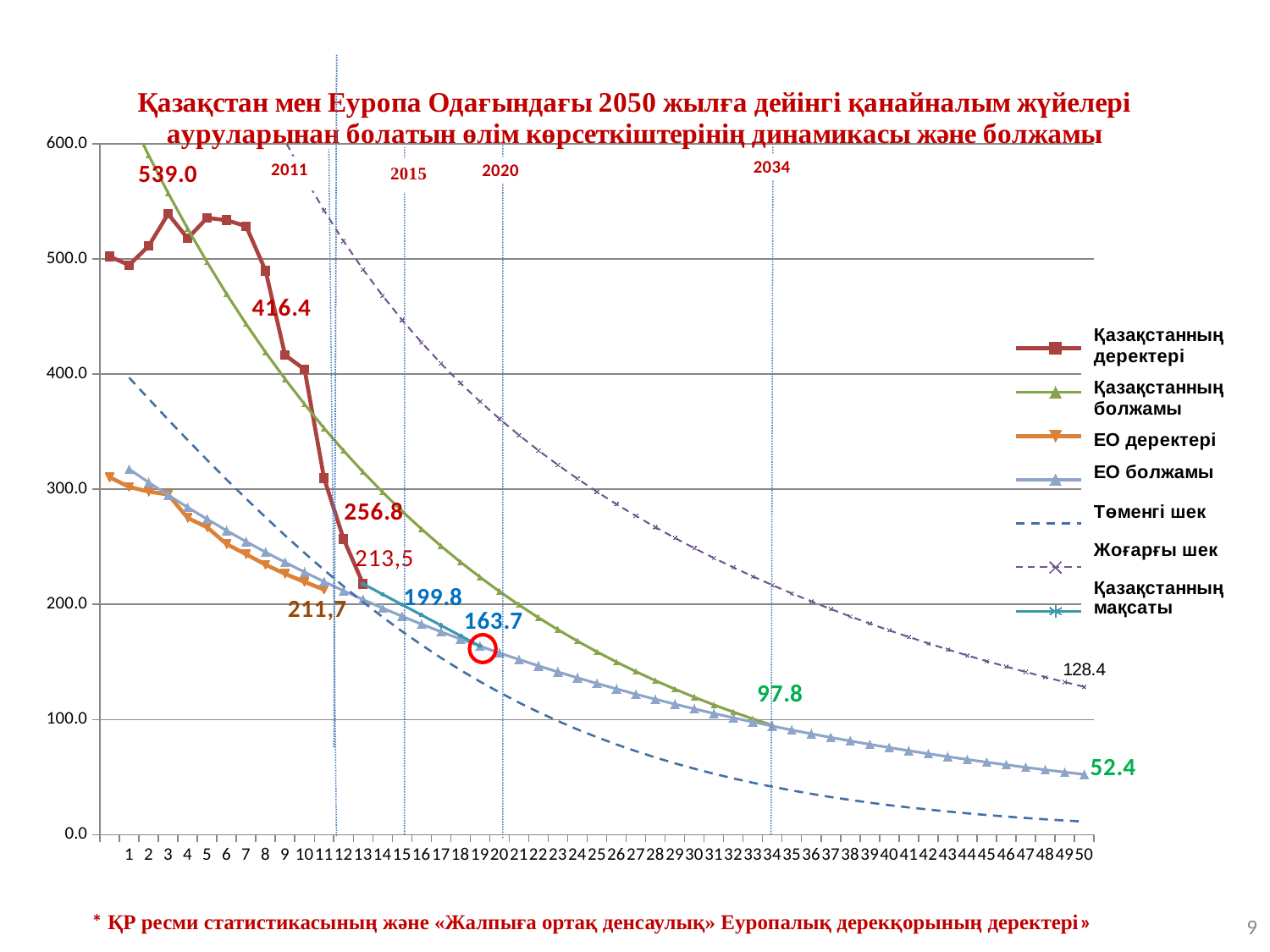
Do the values of the Қазақстанның болжамы line rise or fall along the x axis? fall What value is labelled at the end of the Жоғарғы шек line at point 50? 128.4 What is the difference between the labelled values 539.0 and 416.4 on the Қазақстанның деректері line? 122.6 What value is labelled inside the red circle at the 2020 marker? 163.7 Is the value of the Төменгі шек line at point 50 greater or less than 100.0? less How many series does the legend list? 7 What value is labelled at the end of the ЕО болжамы line at point 50? 52.4 What value is labelled where the lines cross at the 2034 marker? 97.8 How many points are numbered along the x axis? 50 What kind of chart is shown on the slide? line chart What is the highest labelled value on the Қазақстанның деректері line? 539.0